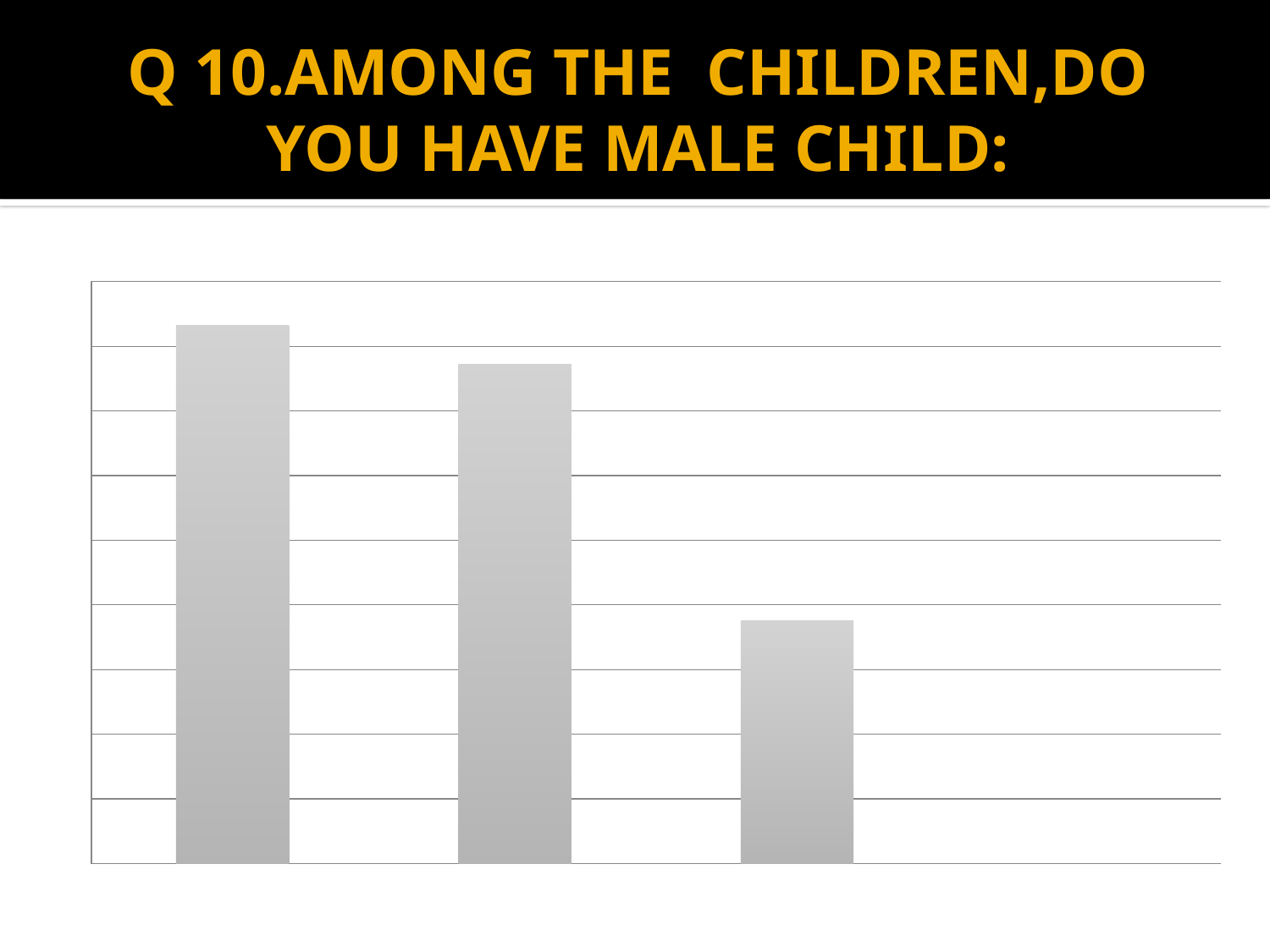
Do the bar heights rise or fall from left to right across the chart? fall Which bar is the tallest: the left, middle, or right bar? left What is the title of the slide containing the chart? Q 10.AMONG THE CHILDREN,DO YOU HAVE MALE CHILD: How many bars are plotted in the chart? 3 What colour are the bars in the chart? grey Is the right bar taller or shorter than the middle bar? shorter What kind of chart is shown on the slide? bar chart Which bar is the shortest: the left, middle, or right bar? right Is the left bar taller or shorter than the middle bar? taller